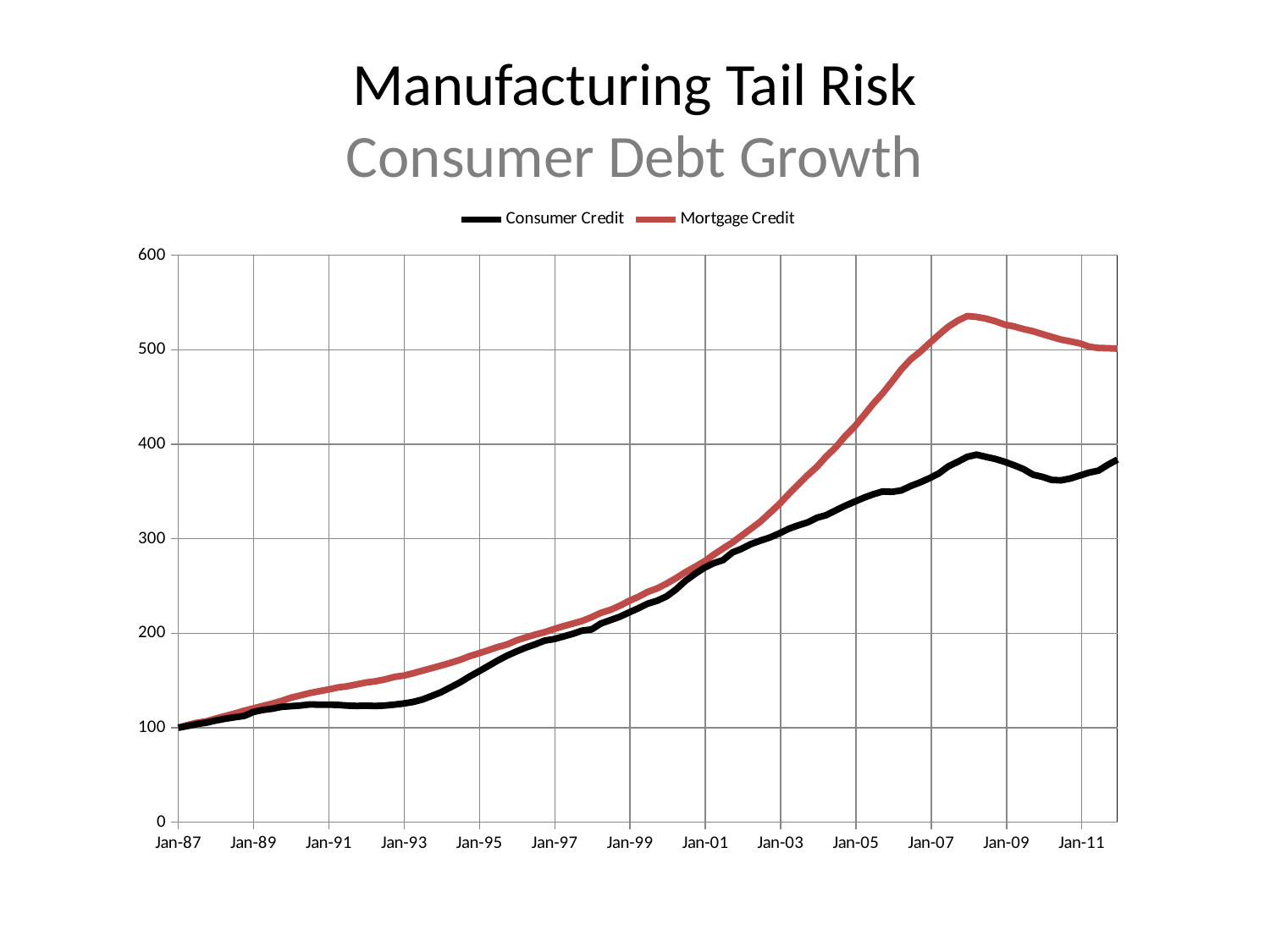
How many series does the legend list? 2 At Jan-09, which series has the higher value, Consumer Credit or Mortgage Credit? Mortgage Credit What kind of chart is shown on the slide? line chart Does the Consumer Credit line generally rise or fall from Jan-87 to Jan-07? rise Is the value for Mortgage Credit at Jan-05 greater or less than 400? greater What value do both Consumer Credit and Mortgage Credit start at in Jan-87? 100 Is the value for Consumer Credit at Jan-07 greater or less than 400? less Is the value for Consumer Credit at Jan-11 greater or less than 300? greater How many year labels are shown on the x axis? 13 Which colour is used for the Mortgage Credit line? red